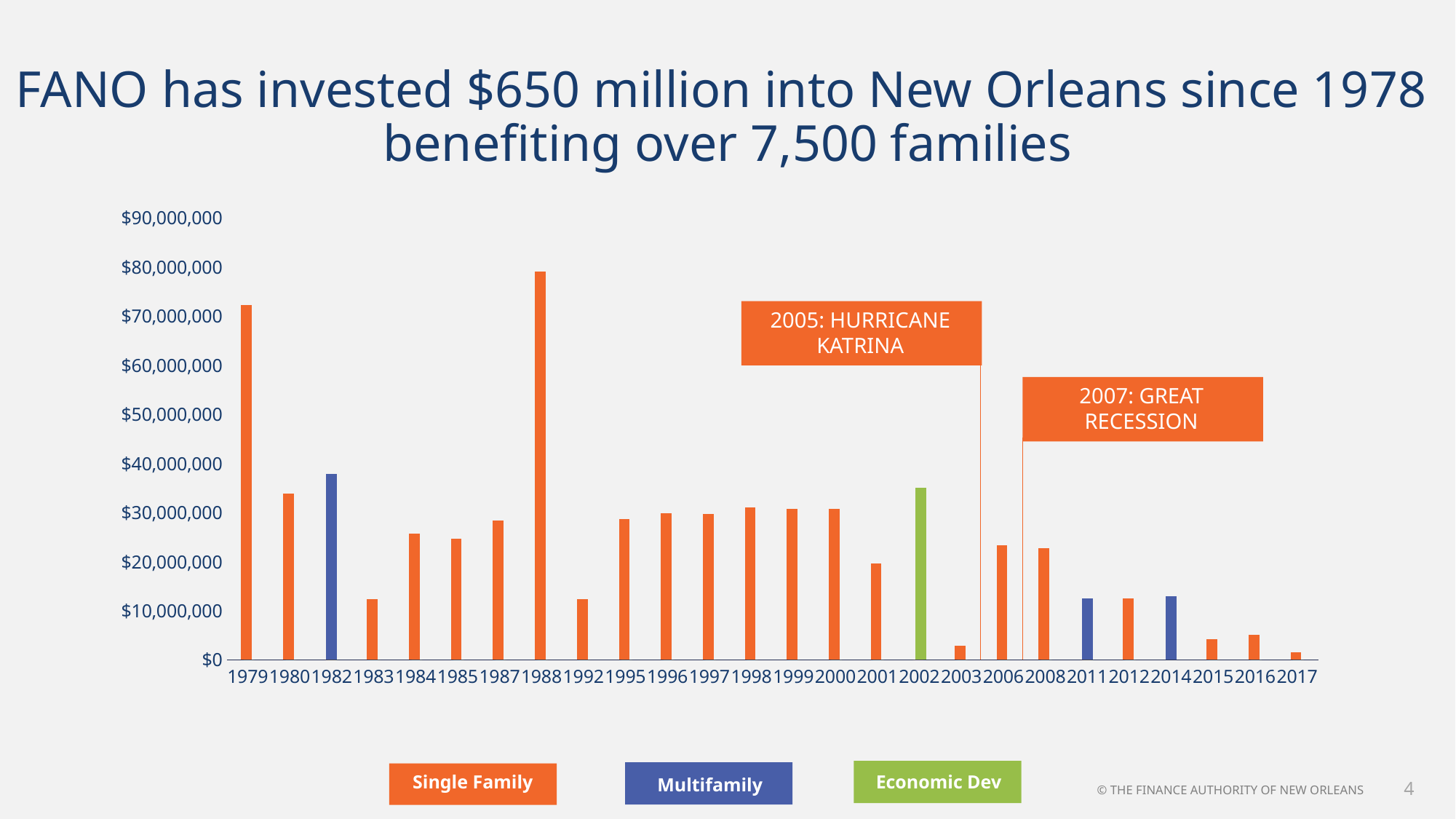
How many years are shown on the x axis of the chart? 26 Is the value for 1988 greater or less than $70,000,000? greater What kind of chart is shown on the slide? bar chart Is the value for 2002 greater or less than $30,000,000? greater How many series does the legend list? 3 Which year has the larger value, 1979 or 1988? 1988 Which year is shown with an Economic Dev bar? 2002 Which year has the lowest bar in the chart? 2017 Is the value for 2003 greater or less than $10,000,000? less Which year has the highest bar in the chart? 1988 Which year has the larger value, 1980 or 1982? 1982 What event does the annotation for 2005 refer to? Hurricane Katrina